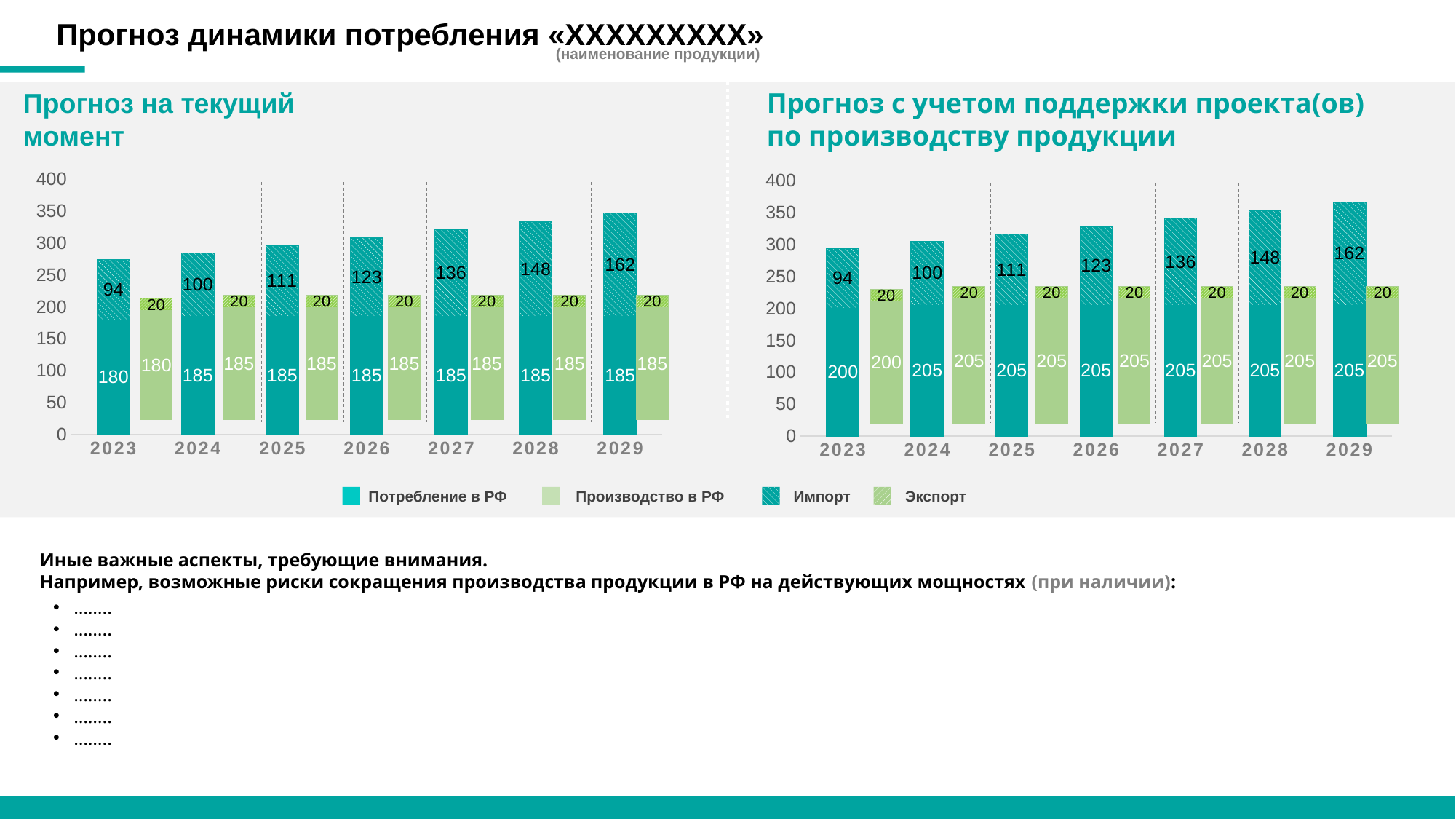
How many series does the shared legend below the charts list? 4 In the left chart 'Прогноз на текущий момент', which year has the highest Импорт value? 2029 In the left chart 'Прогноз на текущий момент', what is the total height of the stacked bar for Потребление в РФ and Импорт in 2029? 347 In the right chart 'Прогноз с учетом поддержки проекта(ов) по производству продукции', what is the value of Экспорт for 2027? 20 In the left chart 'Прогноз на текущий момент', does the Импорт value rise or fall from 2023 to 2029? rise In the left chart 'Прогноз на текущий момент', what is the value of Импорт for 2029? 162 In the right chart 'Прогноз с учетом поддержки проекта(ов) по производству продукции', which year has the lowest Потребление в РФ value? 2023 In the left chart 'Прогноз на текущий момент', what is the difference between the Импорт values for 2029 and 2023? 68 In the right chart 'Прогноз с учетом поддержки проекта(ов) по производству продукции', what is the total of Производство в РФ and Экспорт for 2023? 220 In the right chart 'Прогноз с учетом поддержки проекта(ов) по производству продукции', what is the value of Производство в РФ for 2025? 205 How many years are shown on the x axis of the left chart 'Прогноз на текущий момент'? 7 In the left chart 'Прогноз на текущий момент', what is the value of Потребление в РФ for 2023? 180